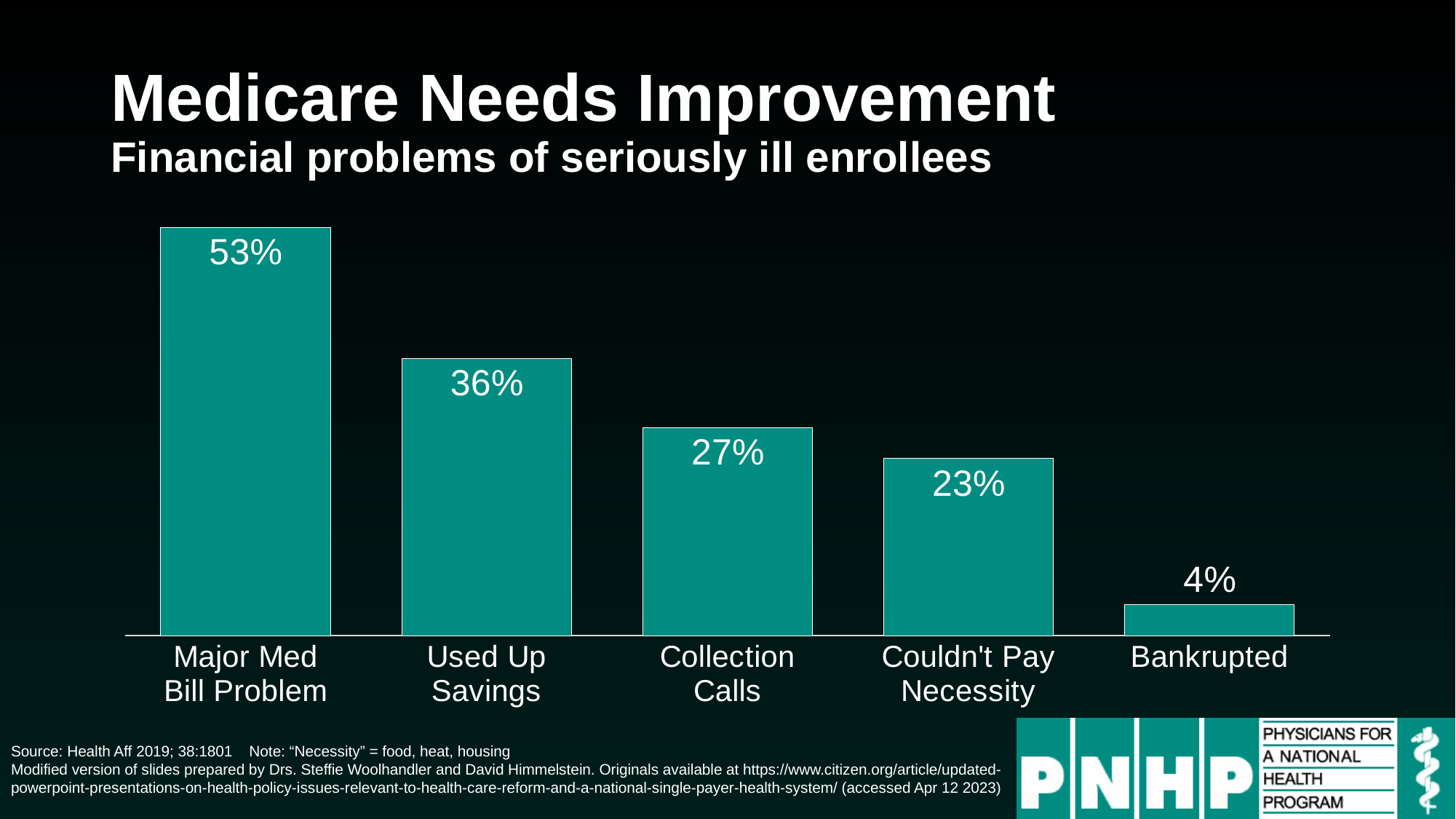
What is the difference between Major Med Bill Problem and Used Up Savings? 17% Which is larger, Collection Calls or Couldn't Pay Necessity? Collection Calls What percentage of enrollees received collection calls? 27% Which category has the highest value? Major Med Bill Problem What percentage of seriously ill enrollees had a major medical bill problem? 53% What is the value for Couldn't Pay Necessity? 23% What kind of chart is shown on the slide? Bar chart Do the values rise or fall from left to right across the categories? Fall What is the value shown for Used Up Savings? 36% What percentage of enrollees were bankrupted? 4% How many categories are shown in the chart? 5 Which category has the lowest value? Bankrupted